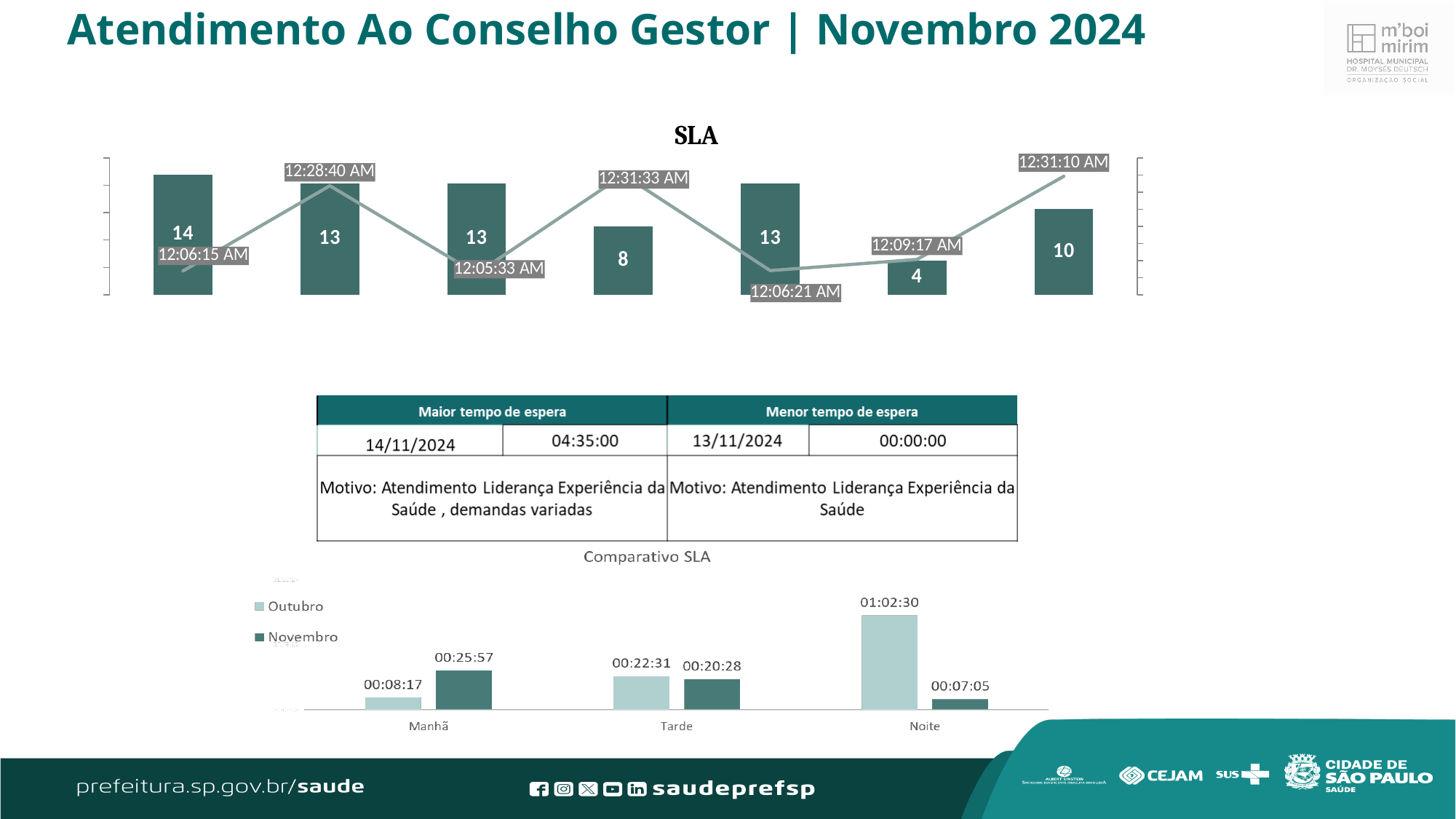
In the Comparativo SLA chart, which category has the highest Outubro value? Noite What kind of chart is the Comparativo SLA chart? Bar chart In the Comparativo SLA chart, for Tarde, which series has the larger value, Outubro or Novembro? Outubro In the Comparativo SLA chart, how many categories are shown on the x axis? 3 In the Comparativo SLA chart, which category has the lowest Novembro value? Noite In the Comparativo SLA chart, how many series does the legend list? 2 In the Comparativo SLA chart, what is the difference between the Outubro and Novembro values for Noite? 00:55:25 In the SLA chart at the top of the slide, what is the highest bar value? 14 In the SLA chart at the top of the slide, how many bars are plotted? 7 In the Comparativo SLA chart, what is the Novembro value for Manhã? 00:25:57 In the SLA chart at the top of the slide, what is the lowest bar value? 4 In the Comparativo SLA chart, what is the Outubro value for Noite? 01:02:30